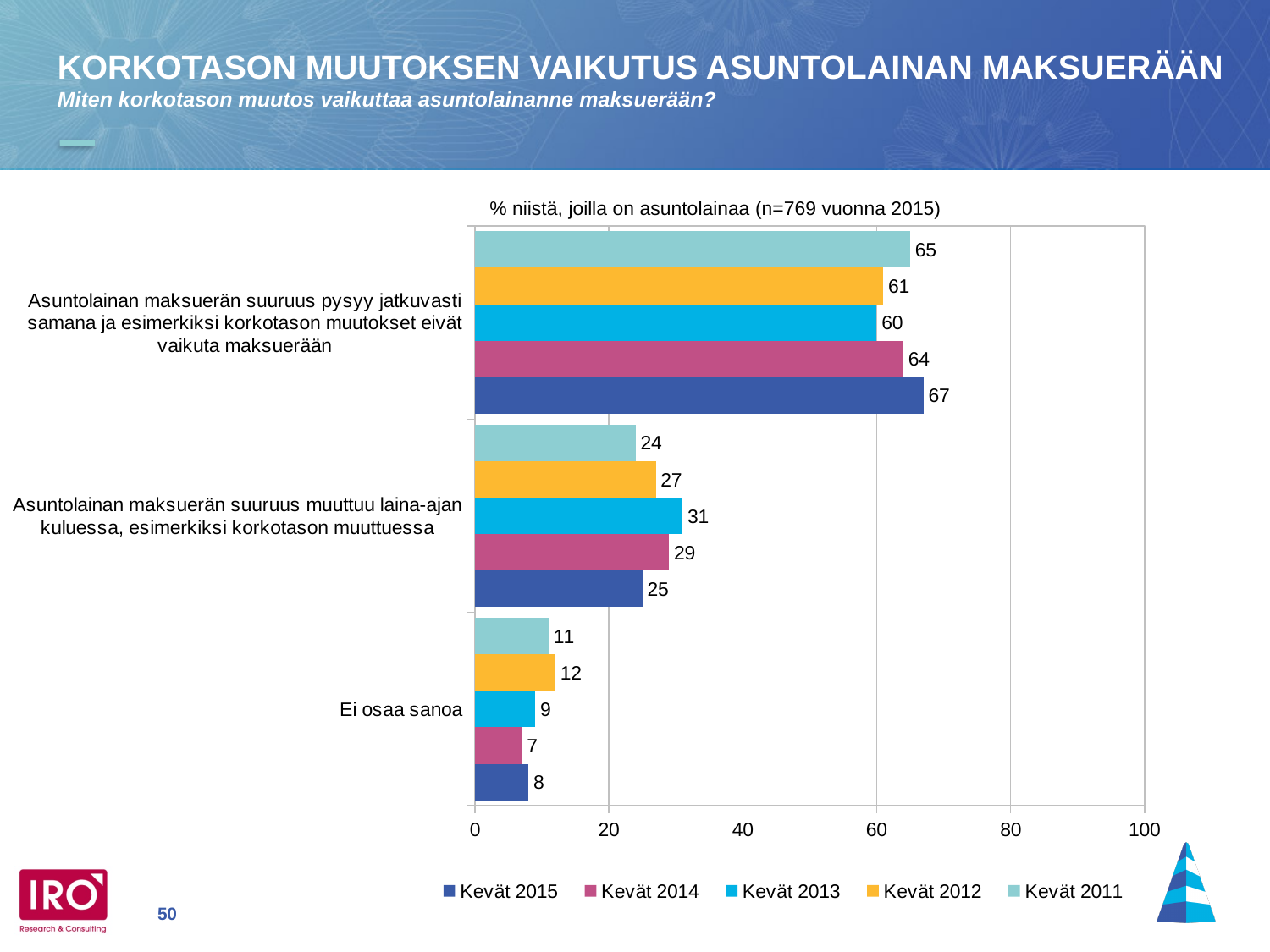
What is the title printed above the chart? % niistä, joilla on asuntolainaa (n=769 vuonna 2015) What kind of chart is shown on the slide? bar chart Which series has the highest value in the category 'Asuntolainan maksuerän suuruus pysyy jatkuvasti samana ja esimerkiksi korkotason muutokset eivät vaikuta maksuerään'? Kevät 2015 In the category 'Asuntolainan maksuerän suuruus muuttuu laina-ajan kuluessa, esimerkiksi korkotason muuttuessa', which is larger: the Kevät 2012 value or the Kevät 2011 value? Kevät 2012 How many categories are shown on the chart? 3 What is the value for Kevät 2013 in the category 'Asuntolainan maksuerän suuruus muuttuu laina-ajan kuluessa, esimerkiksi korkotason muuttuessa'? 31 What is the value for Kevät 2015 in the category 'Ei osaa sanoa'? 8 What is the difference between the Kevät 2015 and Kevät 2013 values in the category 'Asuntolainan maksuerän suuruus pysyy jatkuvasti samana ja esimerkiksi korkotason muutokset eivät vaikuta maksuerään'? 7 Is the Kevät 2014 value for 'Asuntolainan maksuerän suuruus muuttuu laina-ajan kuluessa, esimerkiksi korkotason muuttuessa' greater or less than 40? less How many series does the legend list? 5 Which series has the lowest value in the category 'Ei osaa sanoa'? Kevät 2014 What is the value for Kevät 2011 in the category 'Asuntolainan maksuerän suuruus pysyy jatkuvasti samana ja esimerkiksi korkotason muutokset eivät vaikuta maksuerään'? 65